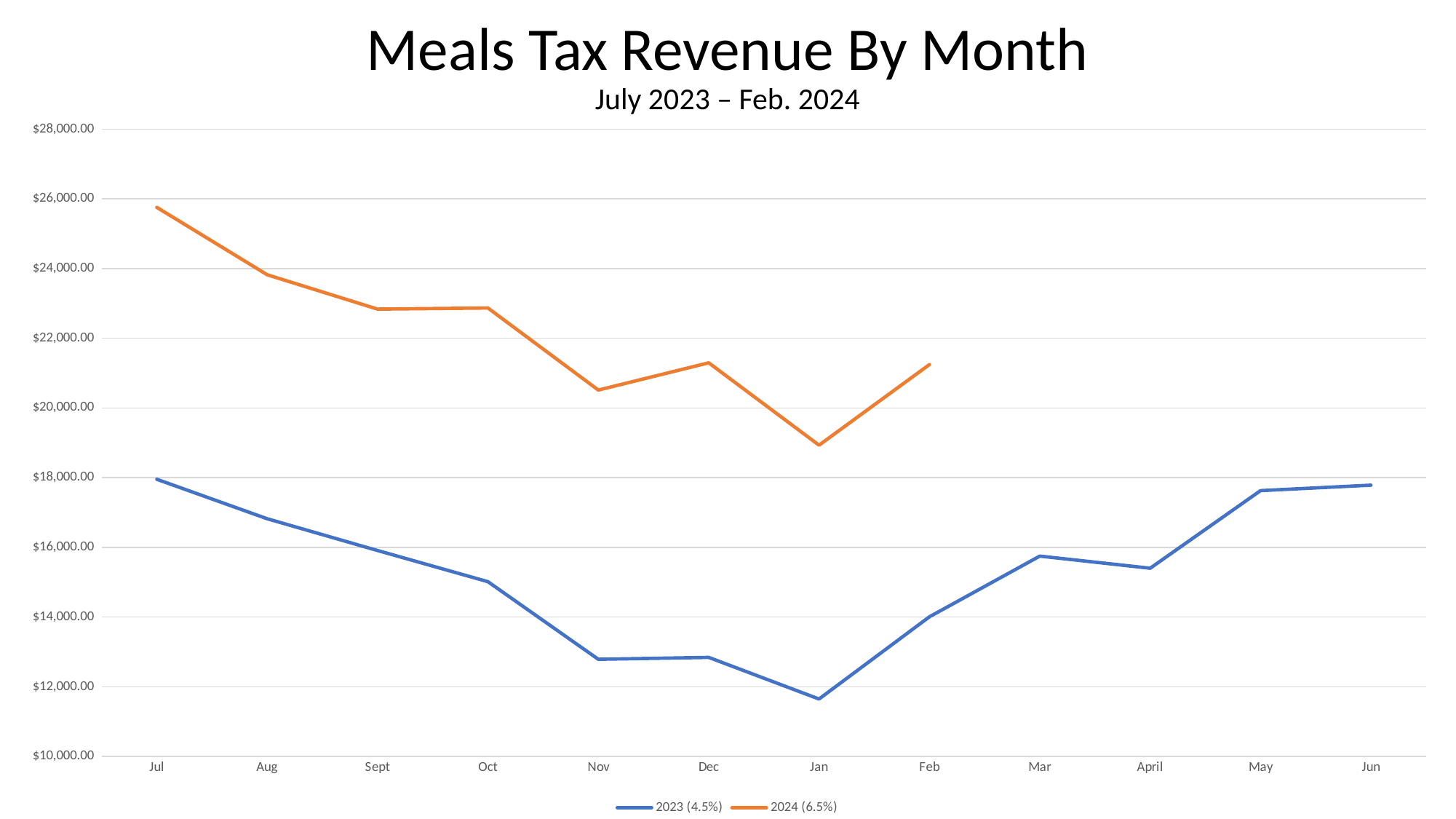
Is the value for the 2024 (6.5%) series in Jan greater or less than $20,000.00? less What is the title of the chart? Meals Tax Revenue By Month How many months are shown on the x axis? 12 What kind of chart is shown on the slide? line chart In which month is the 2024 (6.5%) series at its highest? Jul Is the value for the 2024 (6.5%) series in Jul greater or less than $24,000.00? greater In which month is the 2024 (6.5%) series at its lowest? Jan Does the 2024 (6.5%) series rise or fall from Jul to Nov? fall Which series has the larger value in Dec, 2023 (4.5%) or 2024 (6.5%)? 2024 (6.5%) Is the value for the 2023 (4.5%) series in Jan greater or less than $12,000.00? less How many series does the legend list? 2 In which month is the 2023 (4.5%) series at its lowest? Jan